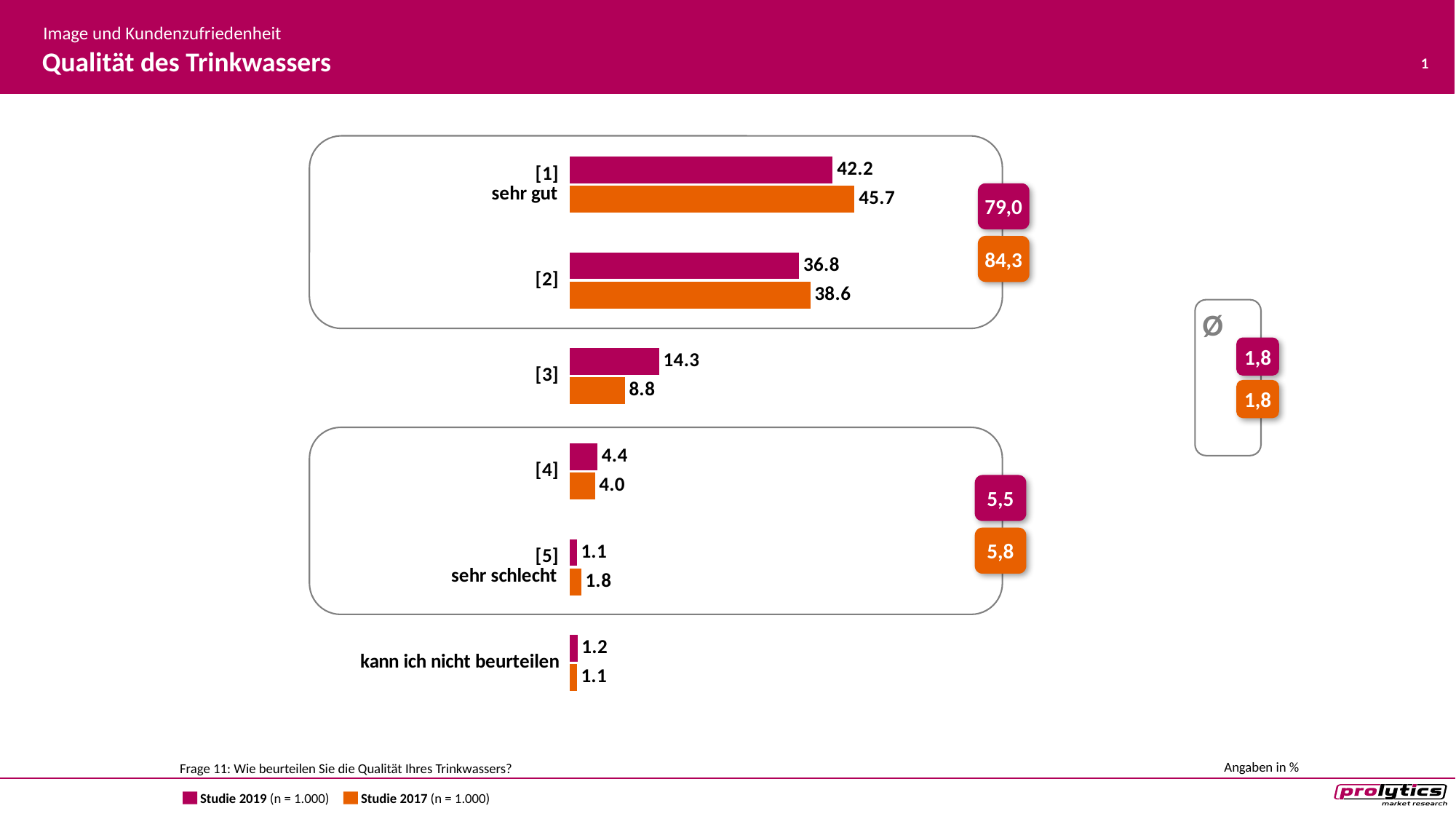
What is the combined value shown for categories [1] and [2] for Studie 2017? 84,3 How many categories are shown in the chart? 6 How many series does the legend list? 2 Which is larger in category [3]: the Studie 2019 value or the Studie 2017 value? Studie 2019 Which category has the lowest value for Studie 2019? [5] sehr schlecht What is the value for Studie 2017 in category [5] sehr schlecht? 1.8 What is the average (Ø) value shown for Studie 2019? 1,8 What kind of chart is shown on the slide? Bar chart Which category has the highest value for Studie 2017? [1] sehr gut What is the difference between the Studie 2017 and Studie 2019 values in category [1] sehr gut? 3.5 What is the value for Studie 2017 in category [3]? 8.8 What is the value for Studie 2019 in category [1] sehr gut? 42.2